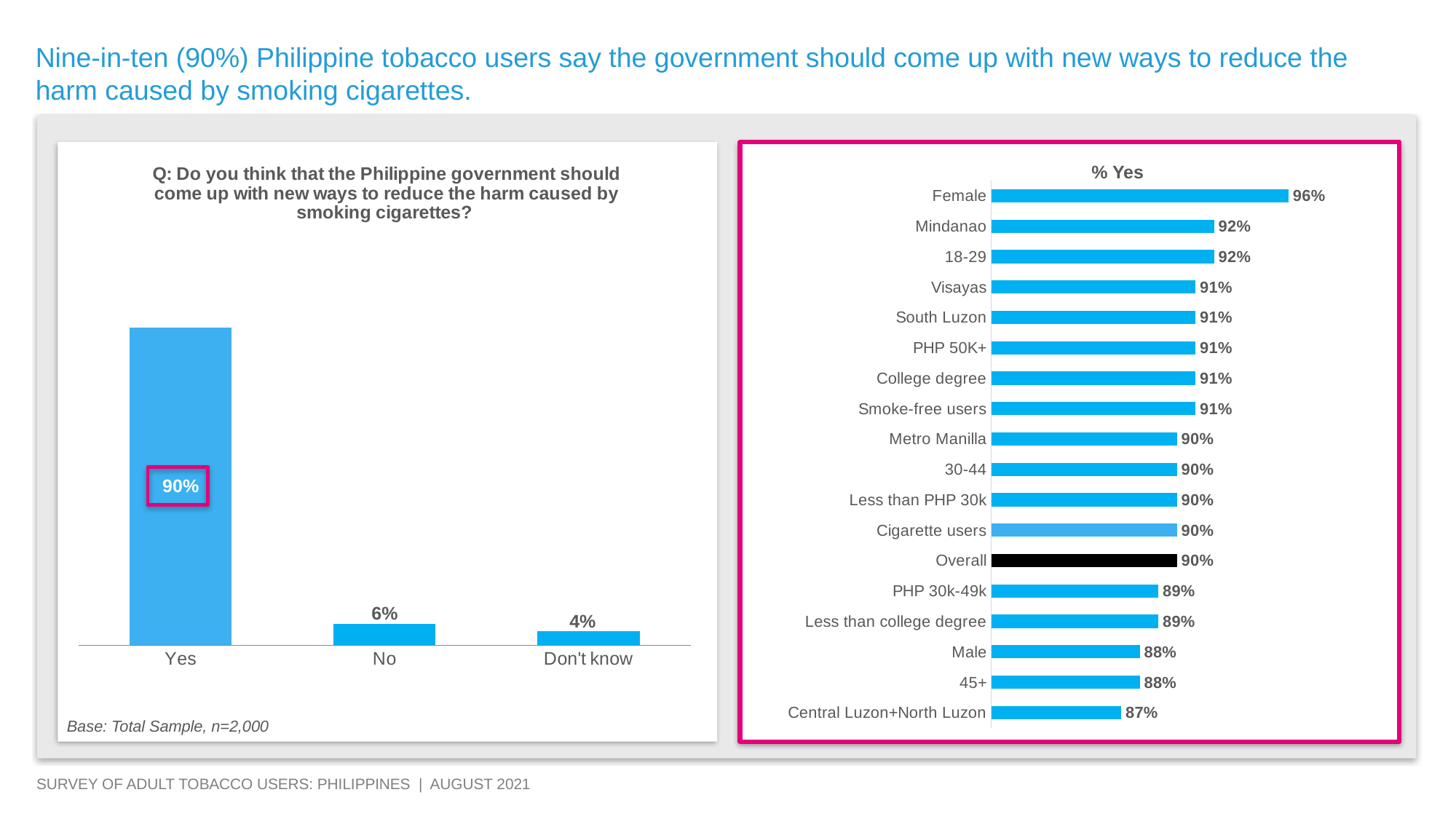
In the left chart, what percentage of respondents answered No? 6% In the % Yes chart, how many groups are listed? 18 In the % Yes chart, which group has the highest value? Female In the left chart, what is the difference between the Yes and No percentages? 84% In the left chart, what percentage of respondents answered Yes? 90% In the left chart, what type of chart is used? Bar chart In the % Yes chart, which group has the lowest value? Central Luzon+North Luzon In the % Yes chart, what is the difference between Female and Male? 8% In the % Yes chart, what is the value for Mindanao? 92% In the % Yes chart, what is the value for Male? 88% In the left chart, how many response categories are shown? 3 In the left chart, what percentage of respondents answered Don't know? 4%